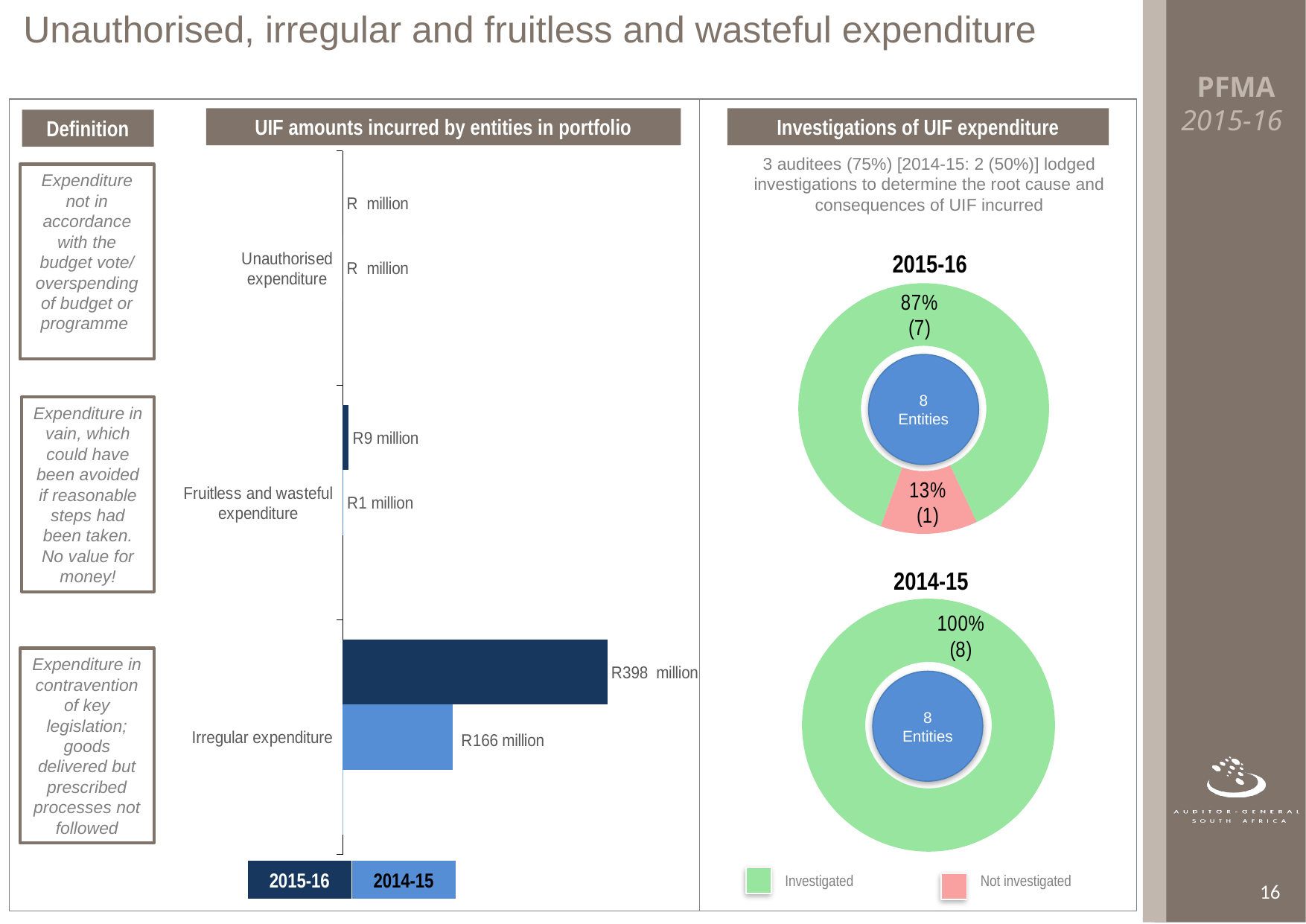
In the 'UIF amounts incurred by entities in portfolio' chart, what is the 2014-15 value for Irregular expenditure? R166 million In the 2015-16 'Investigations of UIF expenditure' chart, what share of entities was not investigated? 13% In the 'UIF amounts incurred by entities in portfolio' chart, what is the 2015-16 value for Irregular expenditure? R398 million What kind of chart is 'UIF amounts incurred by entities in portfolio'? Bar chart In the 'UIF amounts incurred by entities in portfolio' chart, which category has the highest 2015-16 value? Irregular expenditure In the 'UIF amounts incurred by entities in portfolio' chart, what is the difference between the 2015-16 and 2014-15 values for Irregular expenditure? R232 million In the 'UIF amounts incurred by entities in portfolio' chart, what is the 2015-16 value for Fruitless and wasteful expenditure? R9 million In the 'UIF amounts incurred by entities in portfolio' chart, what is the 2014-15 value for Fruitless and wasteful expenditure? R1 million How many series does the legend of the 'UIF amounts incurred by entities in portfolio' chart list? 2 In the 'UIF amounts incurred by entities in portfolio' chart, which is larger for Fruitless and wasteful expenditure: the 2015-16 value or the 2014-15 value? 2015-16 In the 2014-15 'Investigations of UIF expenditure' chart, how many entities were investigated? 8 How many expenditure categories are shown in the 'UIF amounts incurred by entities in portfolio' chart? 3